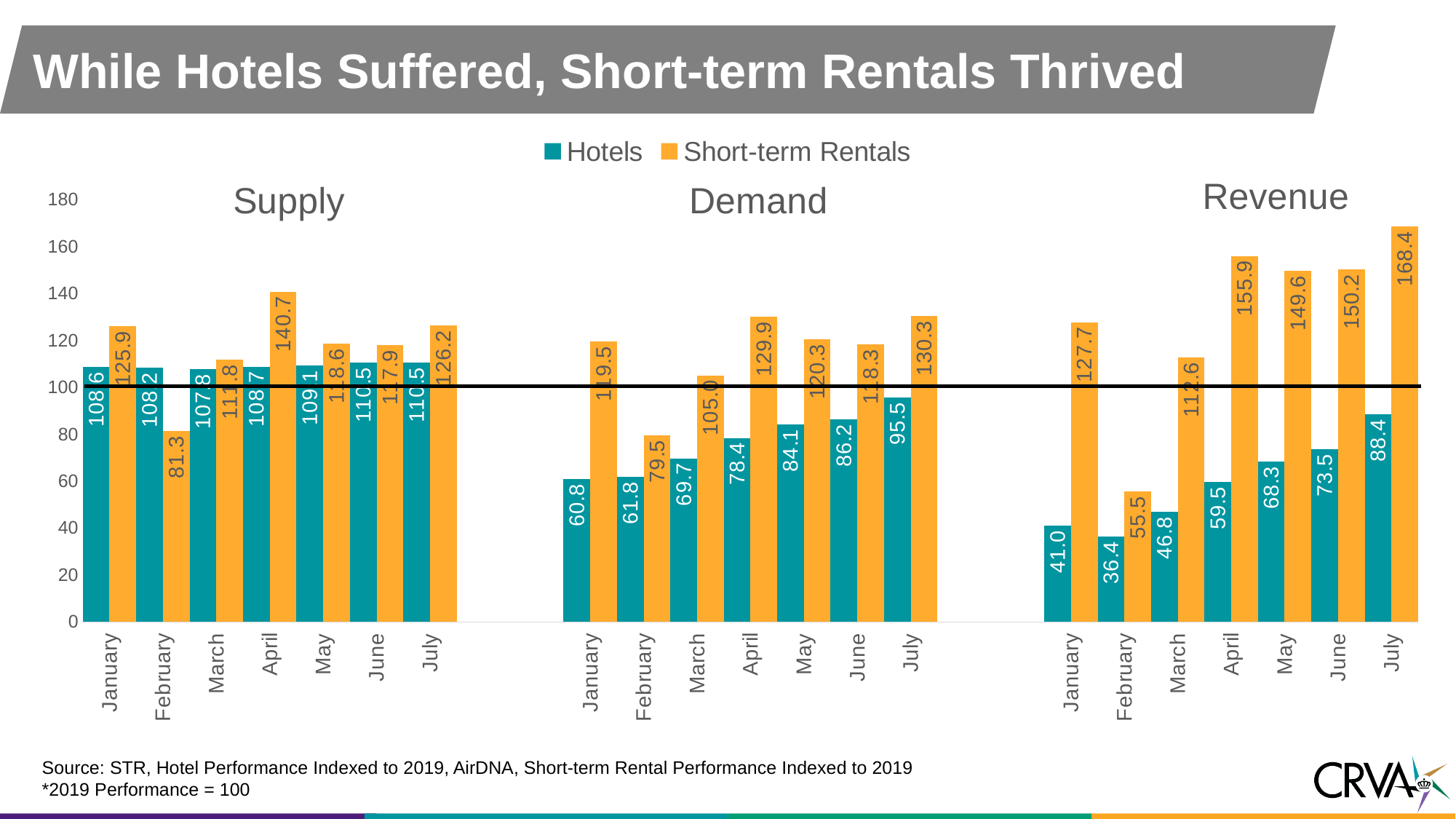
In the Revenue group, which month has the lowest Hotels value? February In the Supply group, is the Short-term Rentals value for February greater or less than 100? less How many series does the legend list? 2 In the Revenue group, which month has the highest Short-term Rentals value? July In the Demand group, do the Hotels values rise or fall from January to July? rise In the Demand group, what is the difference between the Short-term Rentals and Hotels values for July? 34.8 In the Supply group, what is the Short-term Rentals value for April? 140.7 What kind of chart is shown on the slide? bar chart In the Revenue group, what is the Hotels value for February? 36.4 In the Supply group for February, which is larger: Hotels or Short-term Rentals? Hotels In the Demand group, what is the Hotels value for January? 60.8 In the Revenue group, what is the Short-term Rentals value for July? 168.4